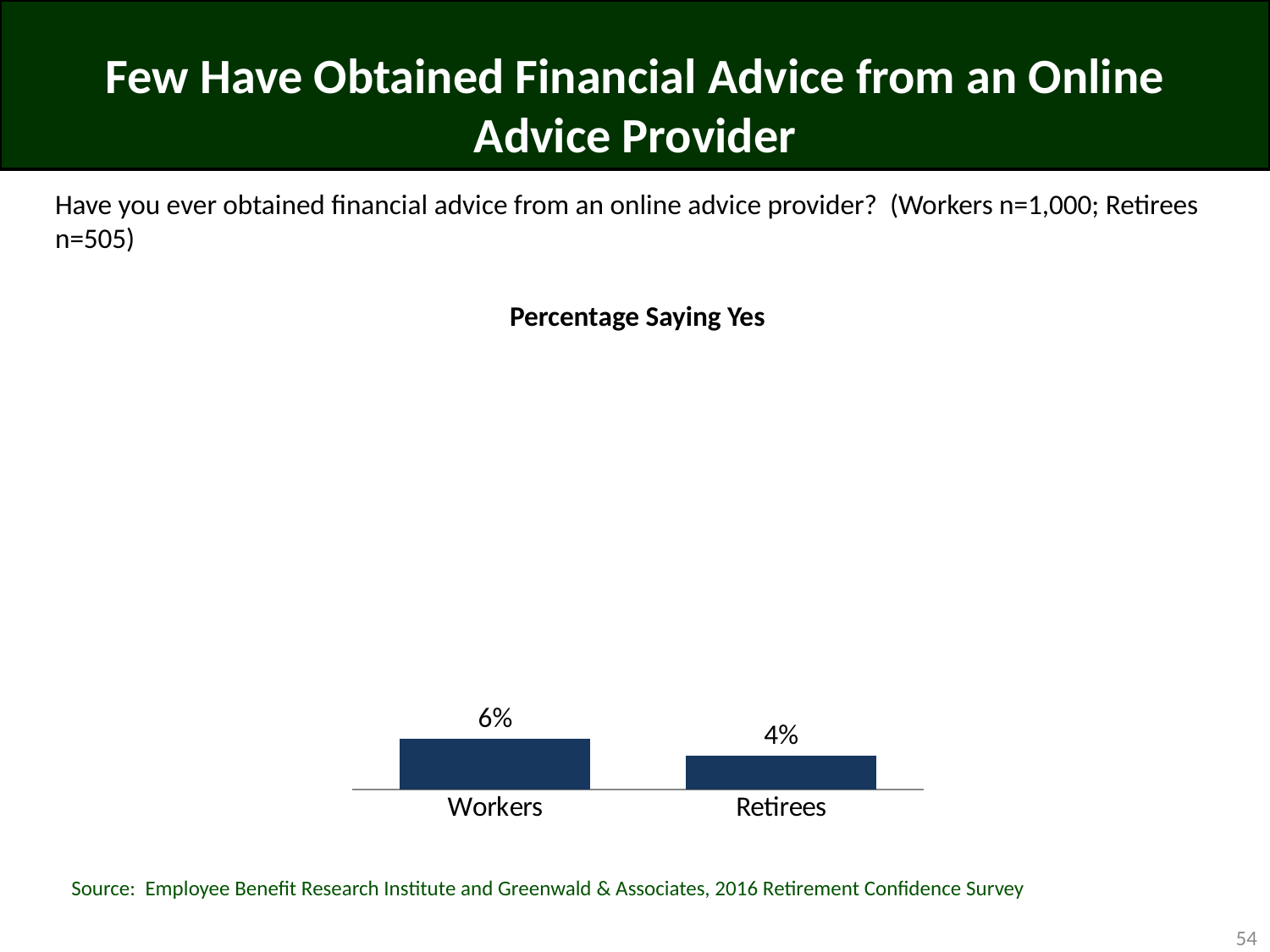
Which group has the lower percentage saying yes? Retirees What kind of chart is shown on the slide? bar chart What is the difference in percentage points between Workers and Retirees saying yes? 2 percentage points Which group has the higher percentage saying yes? Workers What is the title of the chart? Percentage Saying Yes What is the sample size of Workers given in the question text? n=1,000 What percentage of Workers said yes to having obtained financial advice from an online advice provider? 6% How many categories are shown in the chart? 2 What percentage of Retirees said yes to having obtained financial advice from an online advice provider? 4% Is the value for Workers larger or smaller than the value for Retirees? larger